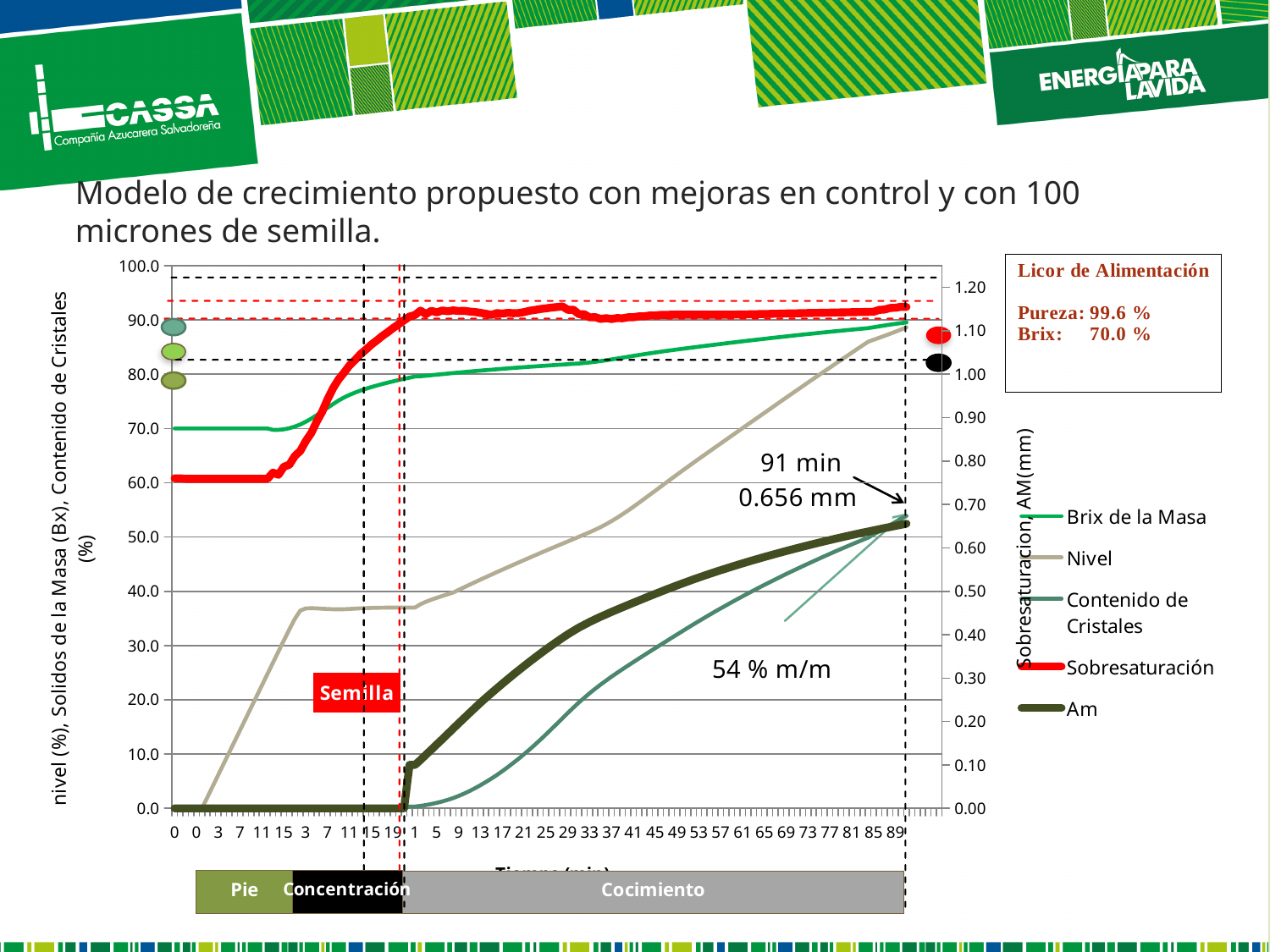
According to the annotation, what is the Am value reached at 91 min? 0.656 mm What kind of chart is shown on the slide? line chart Is the value of Brix de la Masa at the end of the Cocimiento phase greater or less than 80? greater What label marks the red dashed seeding point on the chart? Semilla At 41 minutes of Cocimiento, which is larger: Brix de la Masa or Nivel? Brix de la Masa How many series does the legend list? 5 At what time does the annotated arrow indicate the Am value of 0.656 mm is reached? 91 min According to the annotation, what crystal content (Contenido de Cristales) is reached at the end of the process? 54 % m/m Is the Sobresaturación value at the end of the chart greater or less than 1.10? greater How many process phases are labelled below the x axis? 3 During the Concentración phase, is the Nivel value greater or less than 40? less Does the Nivel series rise or fall over the Cocimiento phase? rise